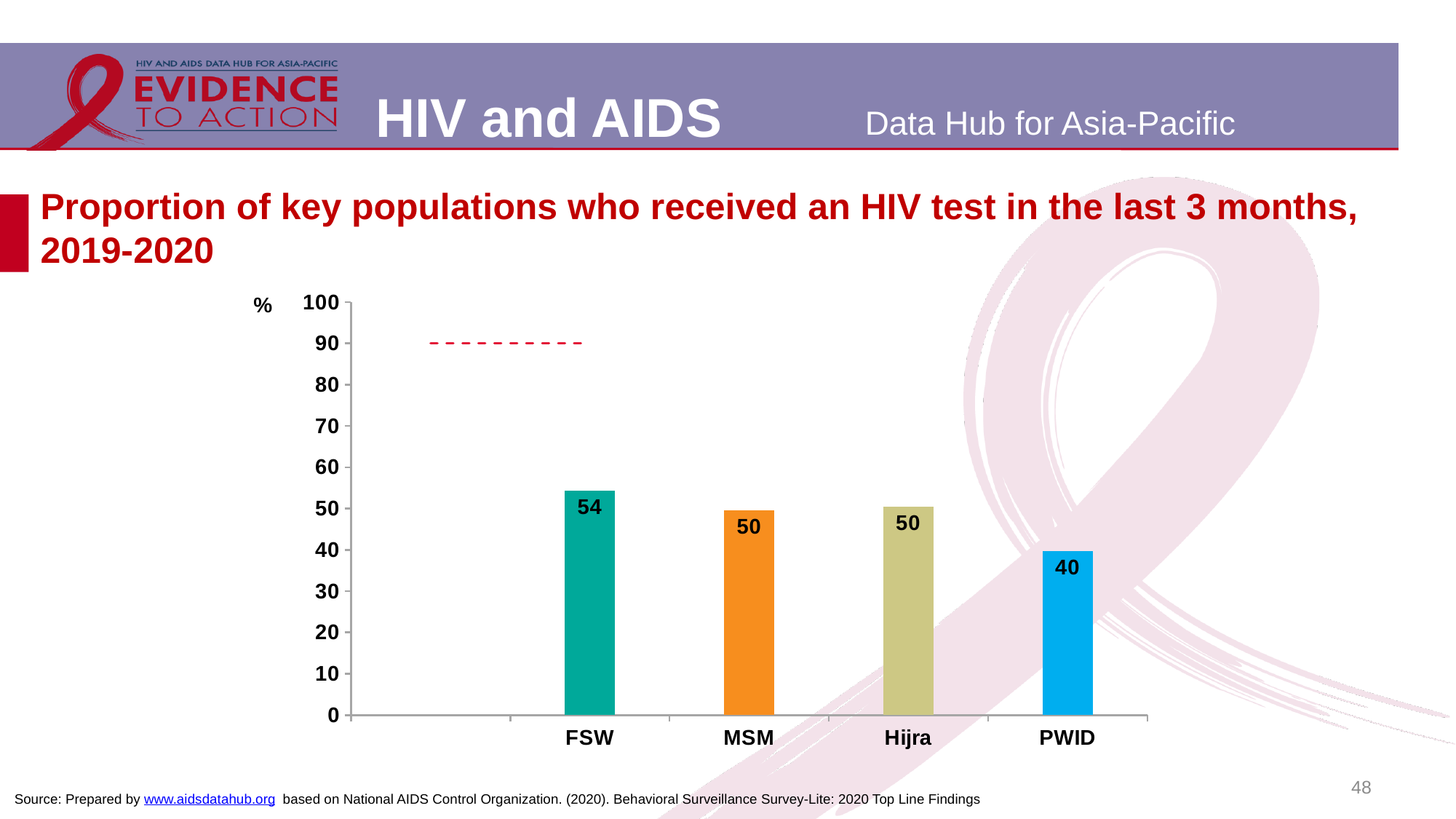
Is the value for PWID greater or less than 50? less What is the value for PWID? 40 Which key population has the lowest proportion who received an HIV test in the last 3 months? PWID What is the value for FSW? 54 Which is larger, the value for FSW or the value for MSM? FSW What unit is shown on the vertical axis of the chart? % What is the difference between the values for FSW and PWID? 14 What kind of chart is shown on the slide? bar chart Which key population has the highest proportion who received an HIV test in the last 3 months? FSW How many key populations are shown on the chart? 4 What is the value for Hijra? 50 What is the value for MSM? 50